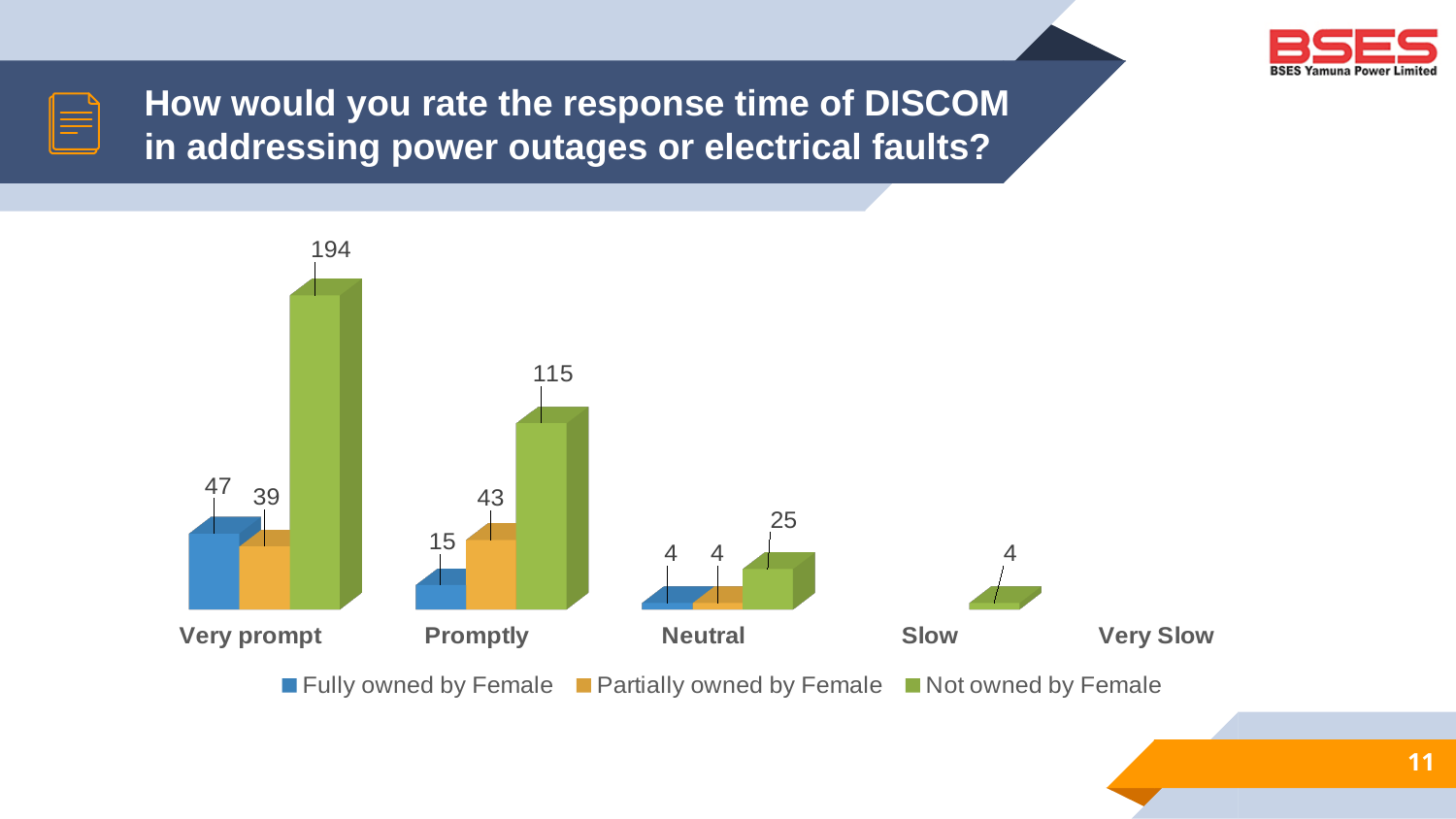
Which category has the highest value for Not owned by Female? Very prompt Which is larger in the Promptly category: Fully owned by Female or Partially owned by Female? Partially owned by Female What is the value for Fully owned by Female in the Promptly category? 15 What is the value for Partially owned by Female in the Very prompt category? 39 Which series is shown in green in the legend? Not owned by Female Which category has the lowest value for Fully owned by Female among those with a labelled bar? Neutral What is the value for Not owned by Female in the Neutral category? 25 How many series does the legend list? 3 What is the difference between the Not owned by Female values for Very prompt and Promptly? 79 What is the value for Not owned by Female in the Very prompt category? 194 What kind of chart is shown on the slide? Bar chart How many categories are shown on the x axis? 5